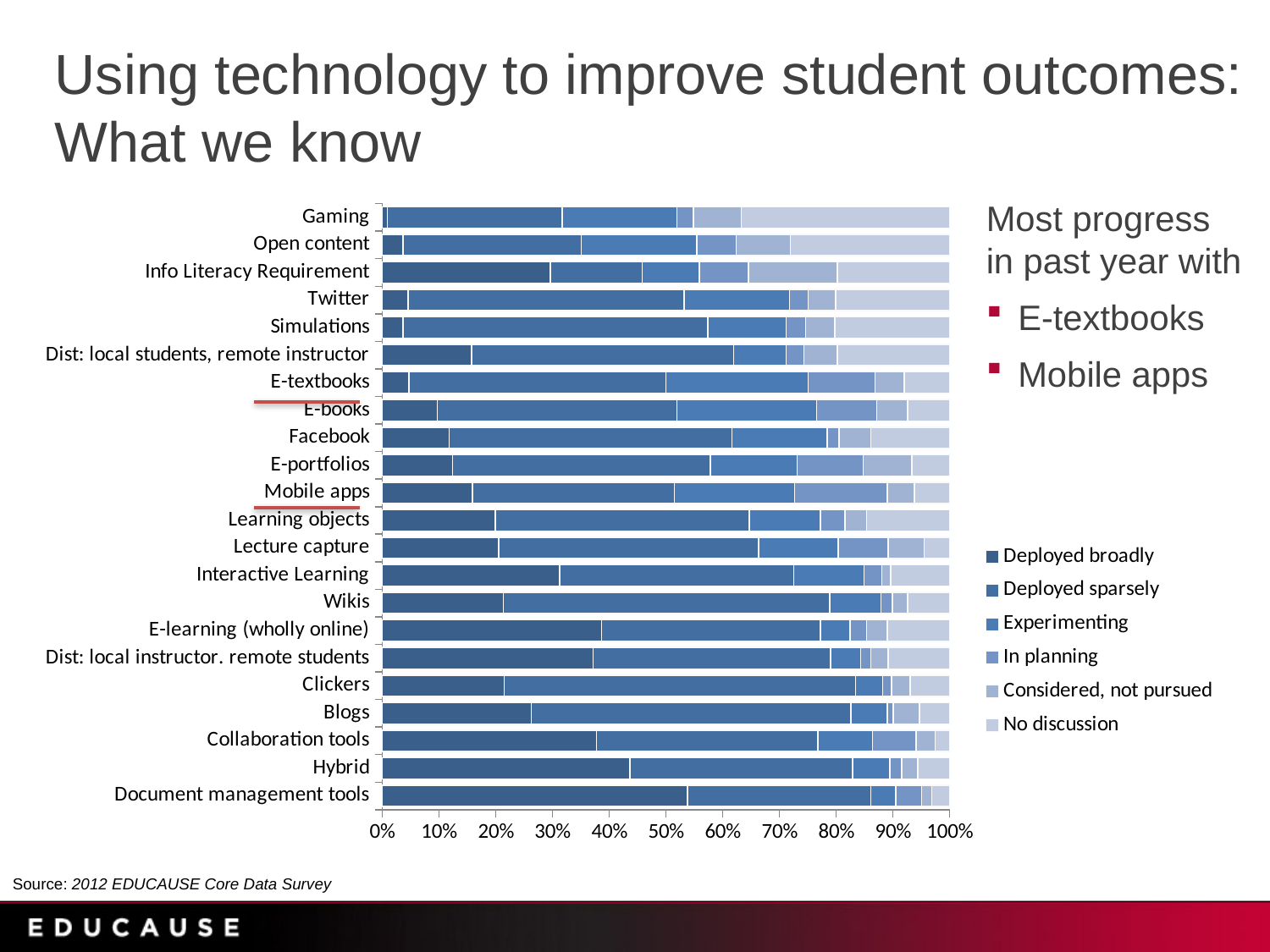
Which category has the largest 'Deployed broadly' segment? Document management tools How many technology categories are listed on the vertical axis of the chart? 22 What kind of chart is shown on the slide? Stacked bar chart Which has the larger 'Deployed broadly' segment, Collaboration tools or Lecture capture? Collaboration tools Which has the larger 'Deployed broadly' segment, Hybrid or Clickers? Hybrid Which two categories on the chart are underlined in red as having made the most progress in the past year? E-textbooks and Mobile apps Is the 'Deployed broadly' value for Gaming greater or less than 10%? less Is the 'Deployed broadly' value for Document management tools greater or less than 50%? greater How many series does the chart's legend list? 6 Is the 'Deployed broadly' value for E-learning (wholly online) greater or less than 30%? greater Which category has the smallest 'Deployed broadly' segment? Gaming